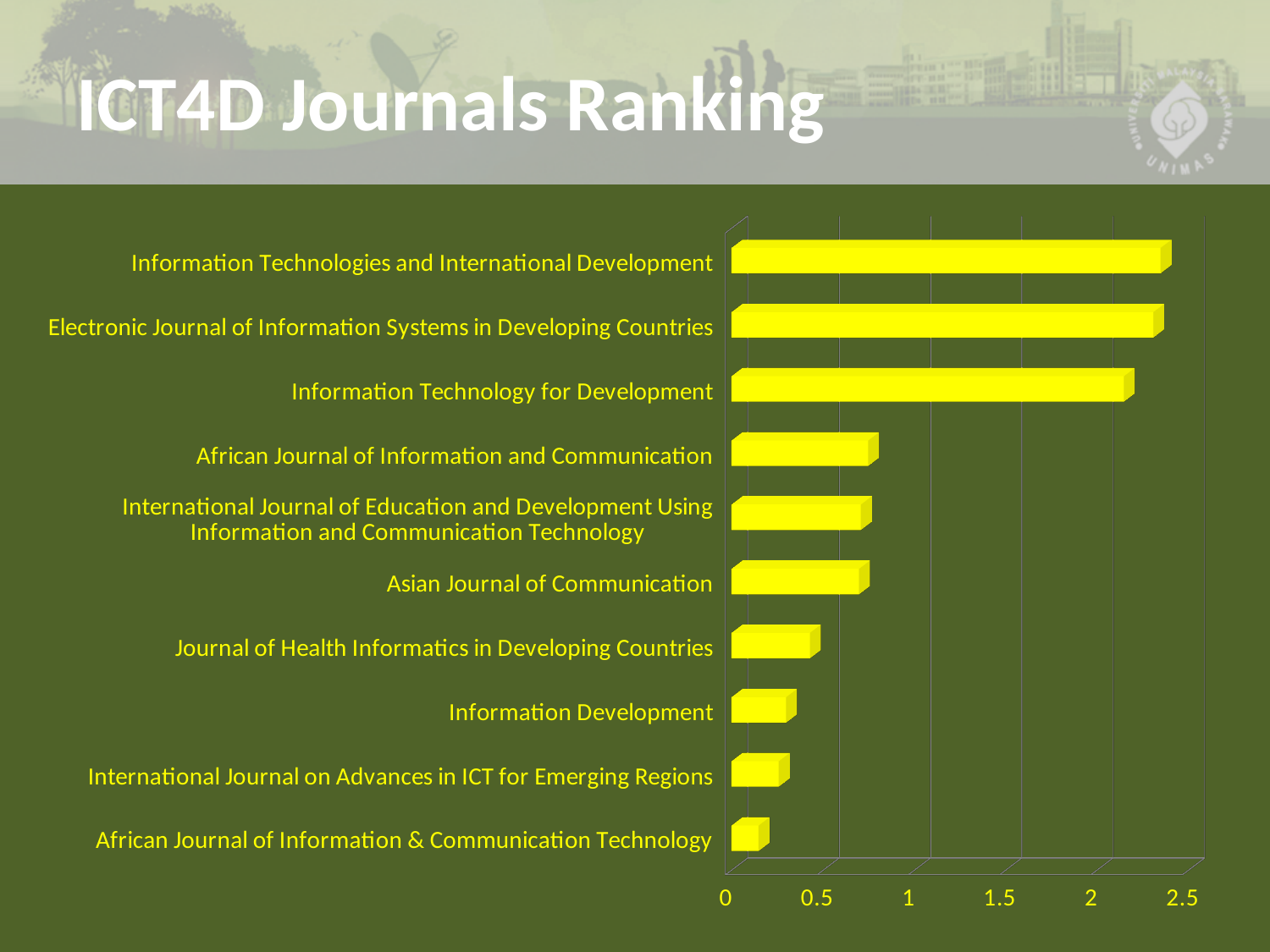
Is the value for Information Technologies and International Development greater or less than 2? greater What colour are the bars in the chart? yellow Is the value for Journal of Health Informatics in Developing Countries greater or less than 0.5? less Which journal has the lowest value in the chart? African Journal of Information & Communication Technology Is the value for African Journal of Information and Communication greater or less than 1? less How many journals are plotted in the chart? 10 What is the title of the slide containing the chart? ICT4D Journals Ranking Which has the larger value: International Journal on Advances in ICT for Emerging Regions or African Journal of Information & Communication Technology? International Journal on Advances in ICT for Emerging Regions What kind of chart is shown on the slide? bar chart Which has the larger value: Information Technology for Development or African Journal of Information and Communication? Information Technology for Development